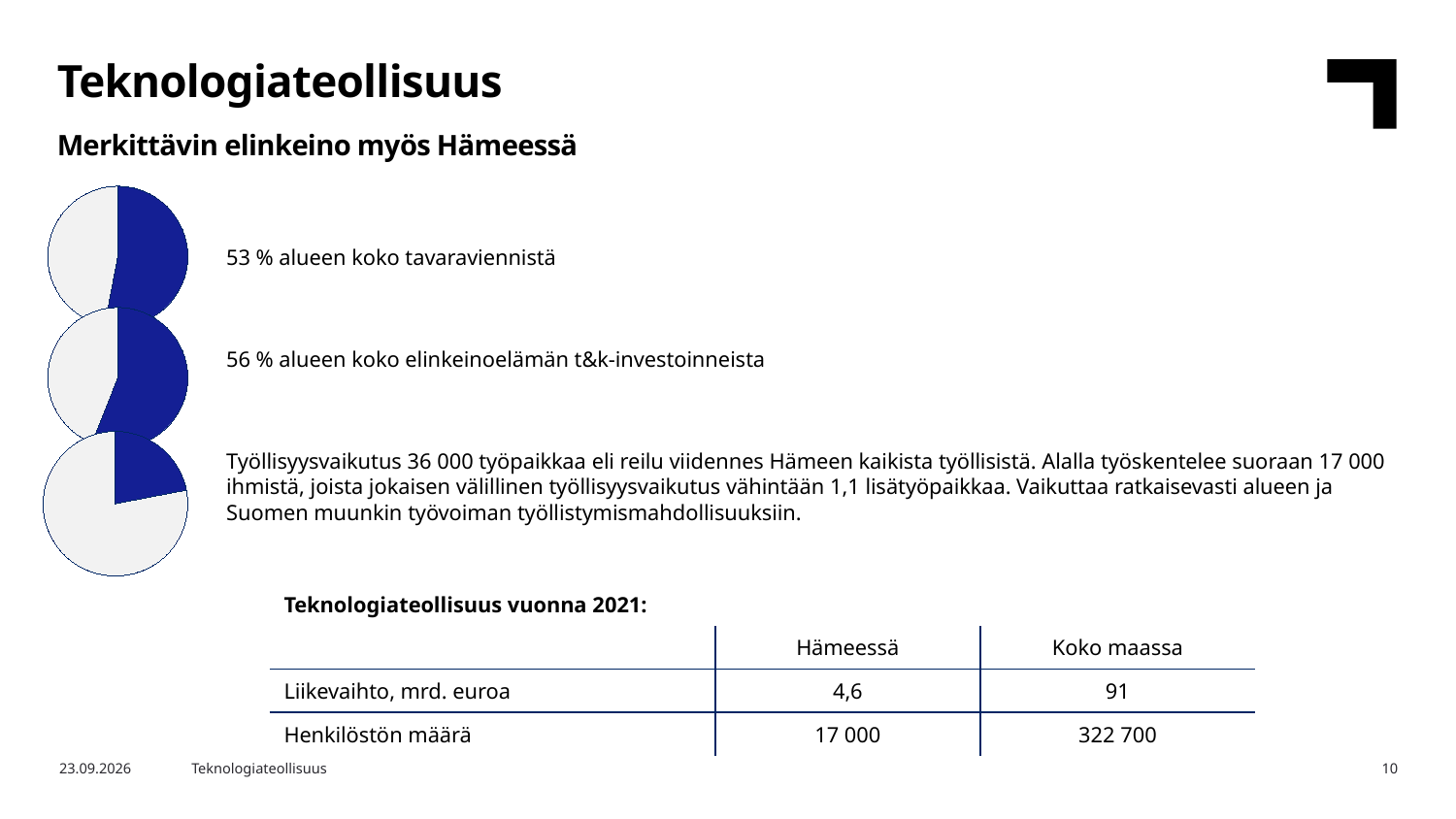
Which pie chart has the smallest blue slice: the top, middle or bottom one? Bottom In the top pie chart, what share of the region's total goods exports (tavaravienti) does the blue slice represent? 53 % What kind of charts are shown on the left side of the slide? Pie charts What colour is used for the highlighted slice in the pie charts? Blue How many pie charts are on the slide? 3 Is the blue slice in the bottom pie chart greater or less than 50 % of the pie? less Which blue share is larger: the top pie chart (goods exports) or the middle pie chart (R&D investments)? Middle pie chart (56 %) What is the difference in percentage points between the blue share of the middle pie chart and the blue share of the top pie chart? 3 percentage points Is the blue slice in the top pie chart greater or less than 50 % of the pie? greater How many slices does each pie chart have? 2 In the middle pie chart, what share of the region's business R&D investments (t&k-investoinnit) does the blue slice represent? 56 % What does the bottom pie chart illustrate, according to the text beside it? Employment impact: 36 000 jobs, just over a fifth of all employed in Häme